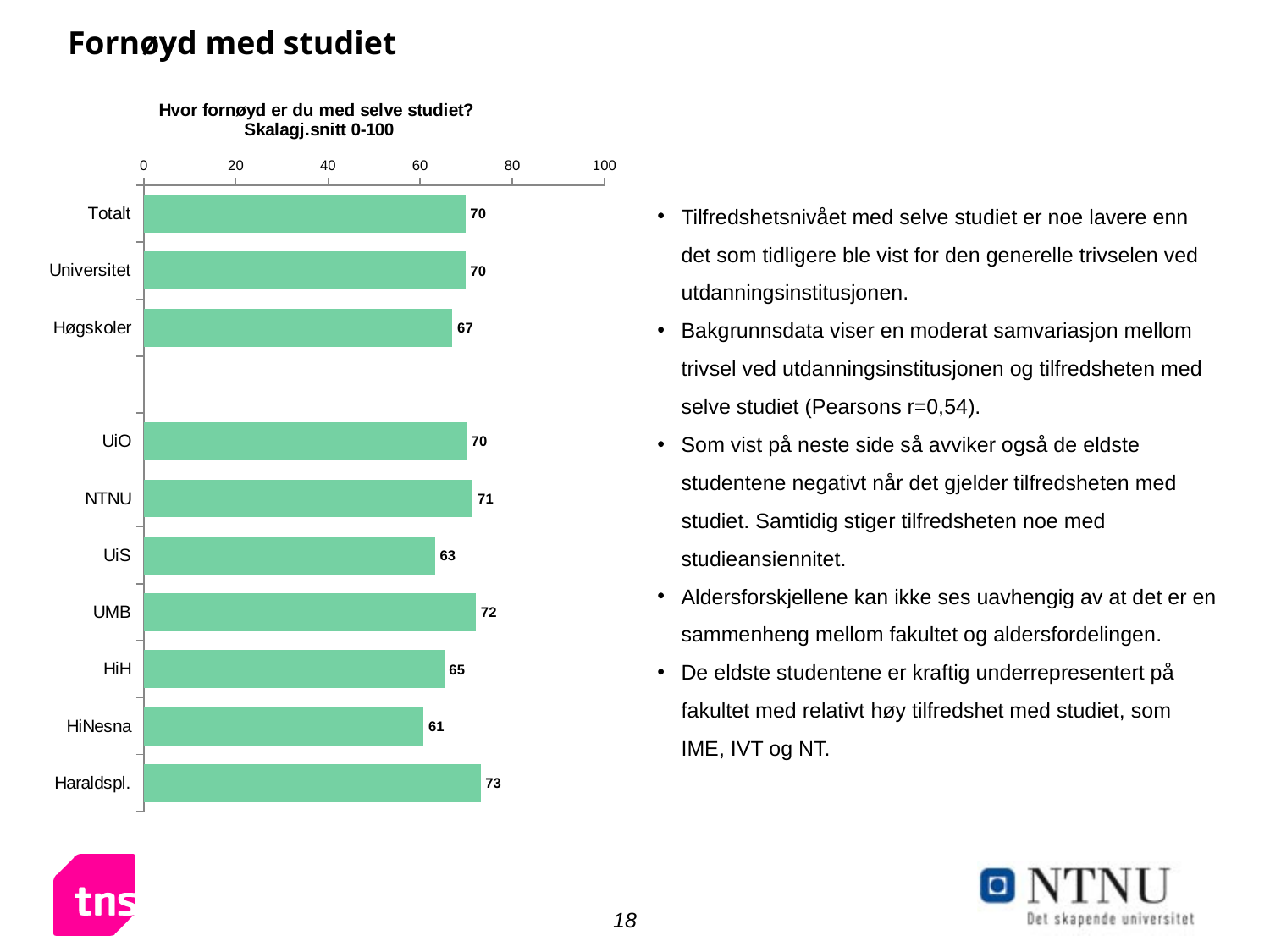
What is the value for HiNesna? 61 What is the value for NTNU? 71 How many bars are plotted in the chart? 10 What is the difference between the values for UMB and UiS? 9 What kind of chart is shown on the slide? bar chart Which category has the lowest value? HiNesna What is the value for Høgskoler? 67 What is the difference between the values for Universitet and Høgskoler? 3 Which category has the highest value? Haraldspl. Is the value for Haraldspl. greater or less than 60? greater What is the title of the chart? Hvor fornøyd er du med selve studiet? Skalagj.snitt 0-100 Which is larger, the value for HiH or the value for UiO? UiO